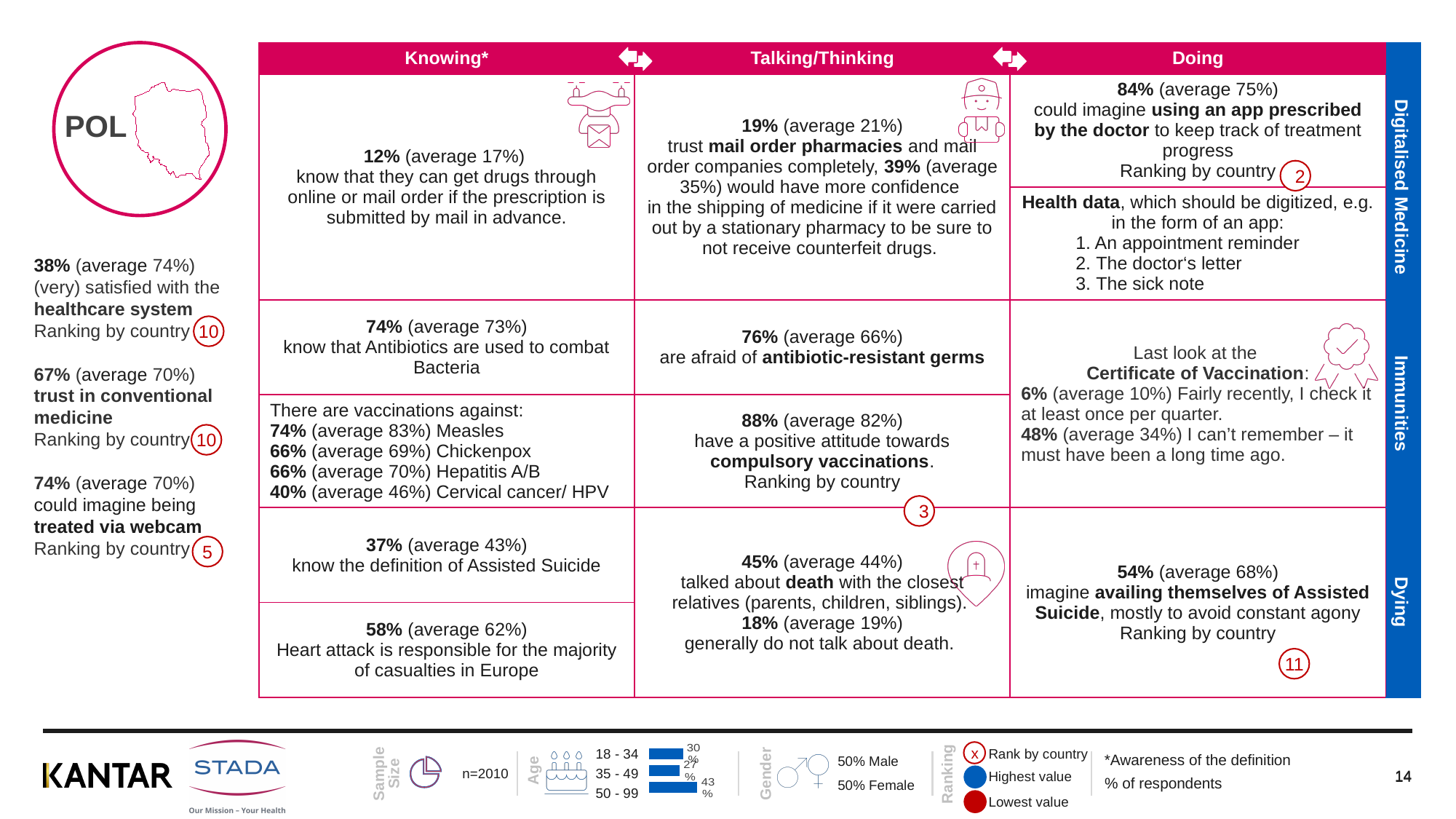
In the age bar chart at the bottom of the slide, which age group has the lowest value? 35 - 49 In the age bar chart at the bottom of the slide, what is the value for the 35 - 49 group? 27% What kind of chart is the age chart at the bottom of the slide? bar chart What is the sample size (n) shown next to the age bar chart at the bottom of the slide? n=2010 In the age bar chart at the bottom of the slide, what is the value for the 50 - 99 group? 43% In the age bar chart at the bottom of the slide, which age group has the highest value? 50 - 99 How many age groups are shown in the age bar chart at the bottom of the slide? 3 What colour are the bars in the age bar chart at the bottom of the slide? blue In the age bar chart at the bottom of the slide, which is larger: the value for 18 - 34 or the value for 50 - 99? 50 - 99 In the age bar chart at the bottom of the slide, what is the difference between the 50 - 99 group and the 35 - 49 group? 16% In the age bar chart at the bottom of the slide, what is the value for the 18 - 34 group? 30% In the age bar chart at the bottom of the slide, what is the difference between the 18 - 34 group and the 35 - 49 group? 3%